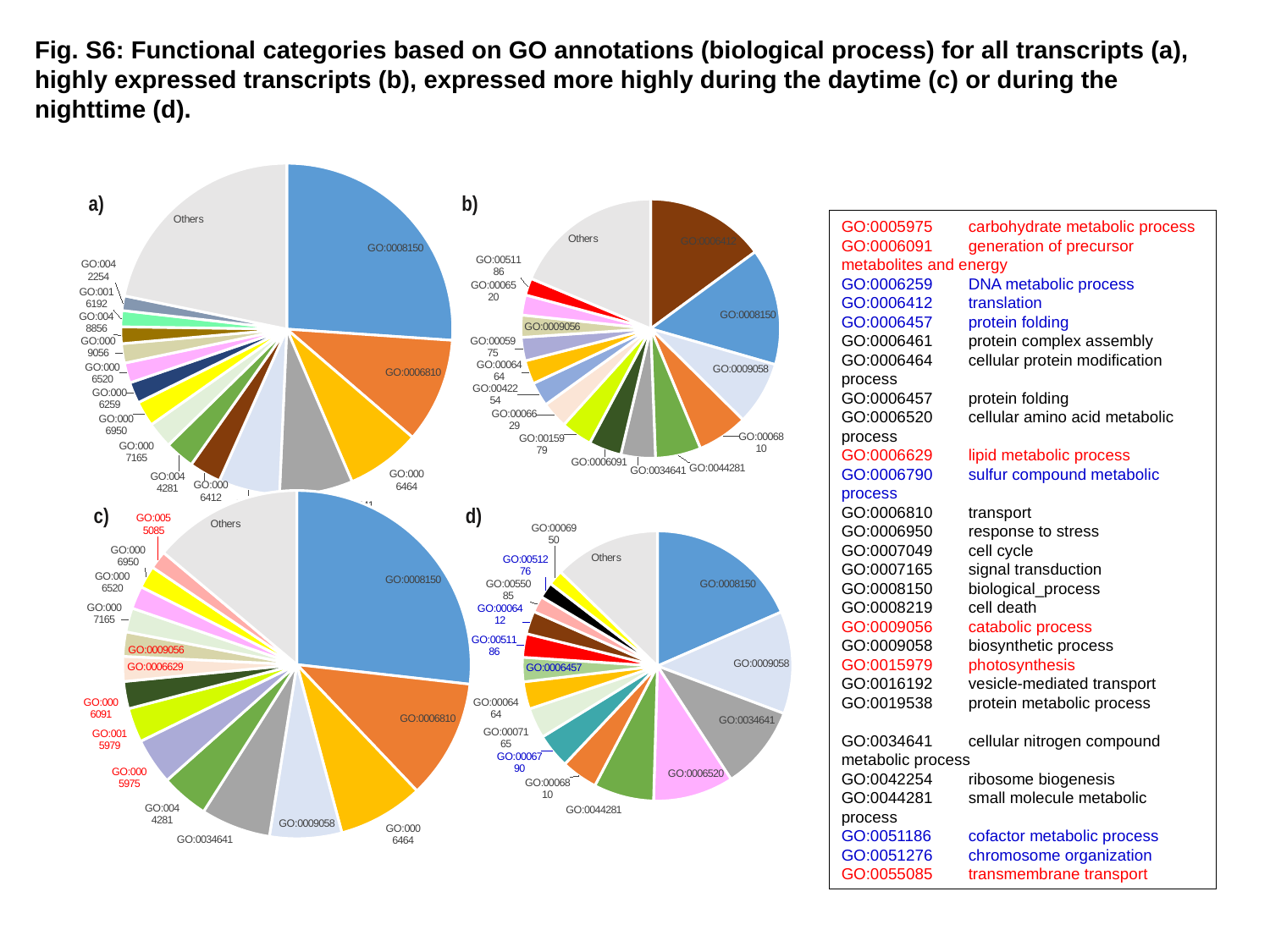
In chart (a), which slice is larger, GO:0008150 or GO:0006810? GO:0008150 Which panel letter labels the pie chart for transcripts expressed more highly during the nighttime? d In chart (c), which category has the largest slice? GO:0008150 In chart (d), which slice is larger, GO:0009058 or GO:0034641? GO:0009058 According to the table on the right, what biological process does GO:0008150 correspond to? biological_process What kind of chart is used in panel (a)? pie chart In chart (c), which slice is larger, GO:0006810 or GO:0009058? GO:0006810 How many pie charts are shown on the slide? 4 In chart (a), which category has the largest slice? GO:0008150 In chart (d), which category has the largest slice? GO:0008150